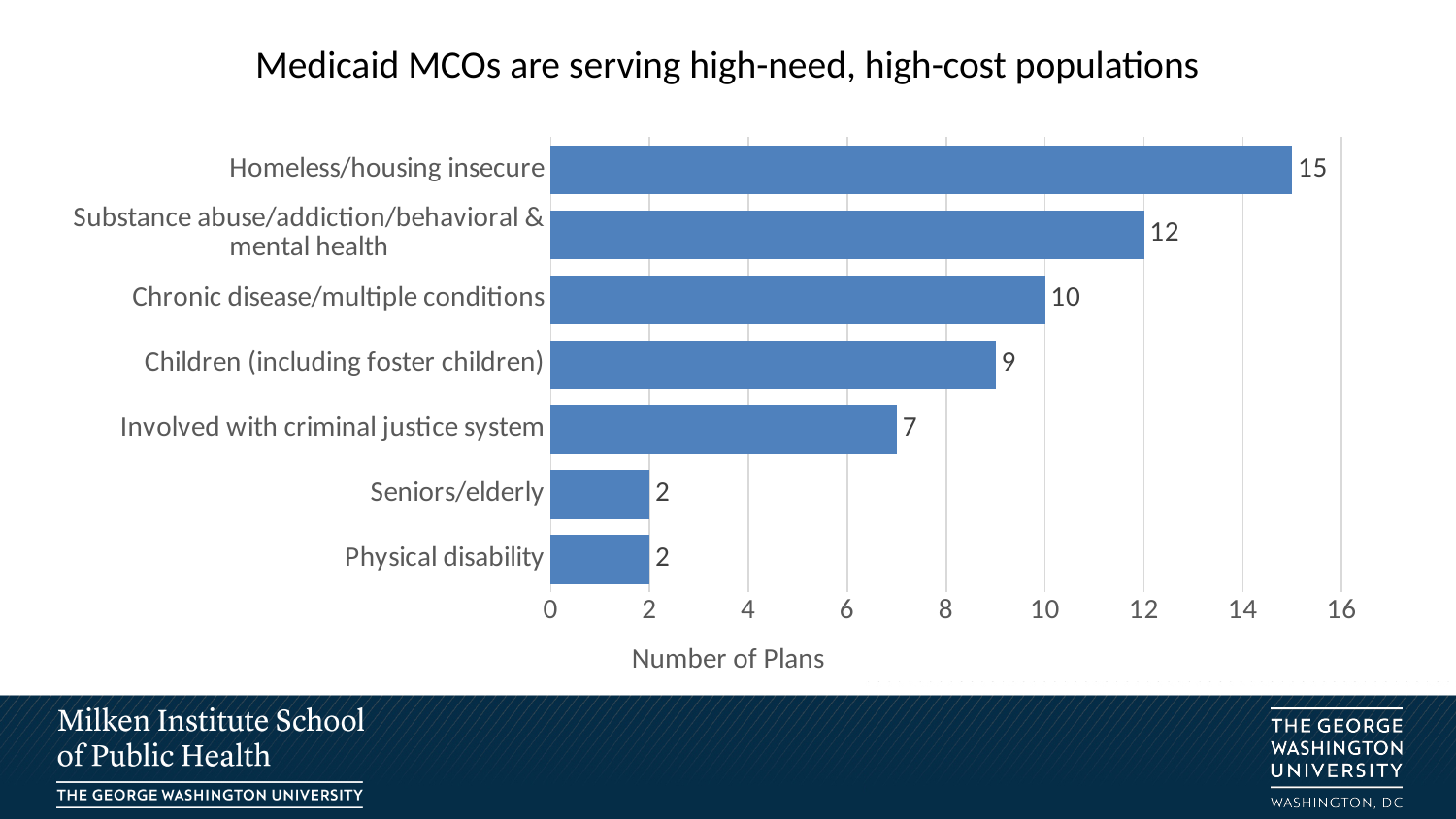
Which has more plans: Children (including foster children) or Involved with criminal justice system? Children (including foster children) How many population categories are shown in the chart? 7 What is the label of the horizontal axis? Number of Plans Which population is served by the most plans? Homeless/housing insecure What is the difference in number of plans between Homeless/housing insecure and Substance abuse/addiction/behavioral & mental health? 3 How many plans serve people involved with the criminal justice system? 7 What is the title of the chart? Medicaid MCOs are serving high-need, high-cost populations How many plans serve Seniors/elderly? 2 How many plans serve the Homeless/housing insecure population? 15 What type of chart is shown on the slide? Bar chart What is the difference in number of plans between Chronic disease/multiple conditions and Physical disability? 8 What is the number of plans for Chronic disease/multiple conditions? 10